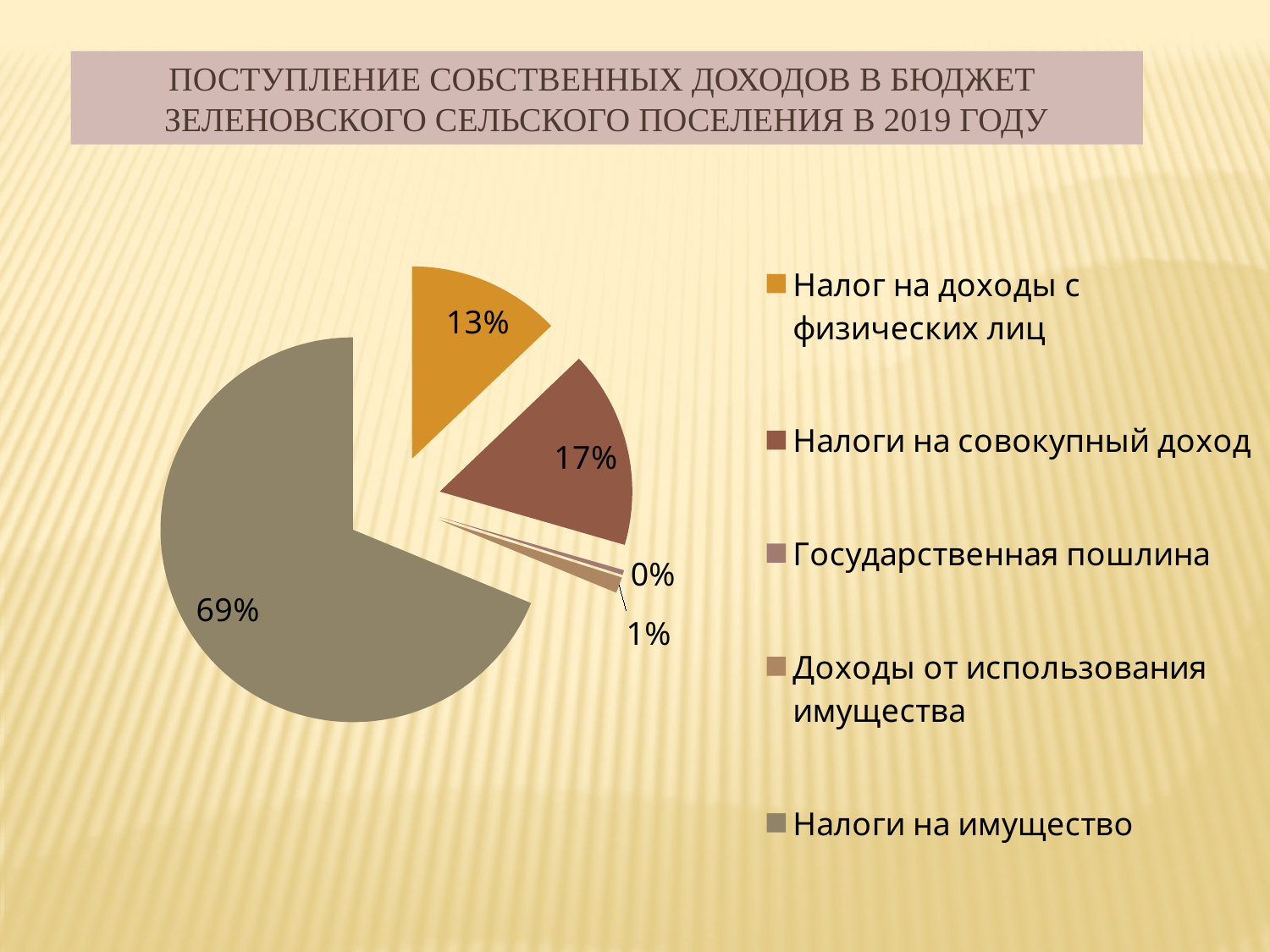
What share of the pie does "Налоги на имущество" have? 69% What share of the pie does "Налог на доходы с физических лиц" have? 13% What share of the pie does "Государственная пошлина" have? 0% What type of chart is shown on the slide? pie chart How many categories does the legend list? 5 Which category has the largest share of the pie? Налоги на имущество What is the title of the chart on the slide? Поступление собственных доходов в бюджет Зеленовского сельского поселения в 2019 году Which category has the smallest share of the pie? Государственная пошлина What is the difference in percentage points between the share for "Налоги на имущество" and the share for "Налоги на совокупный доход"? 52 Which is larger: the share for "Налоги на совокупный доход" or the share for "Налог на доходы с физических лиц"? Налоги на совокупный доход